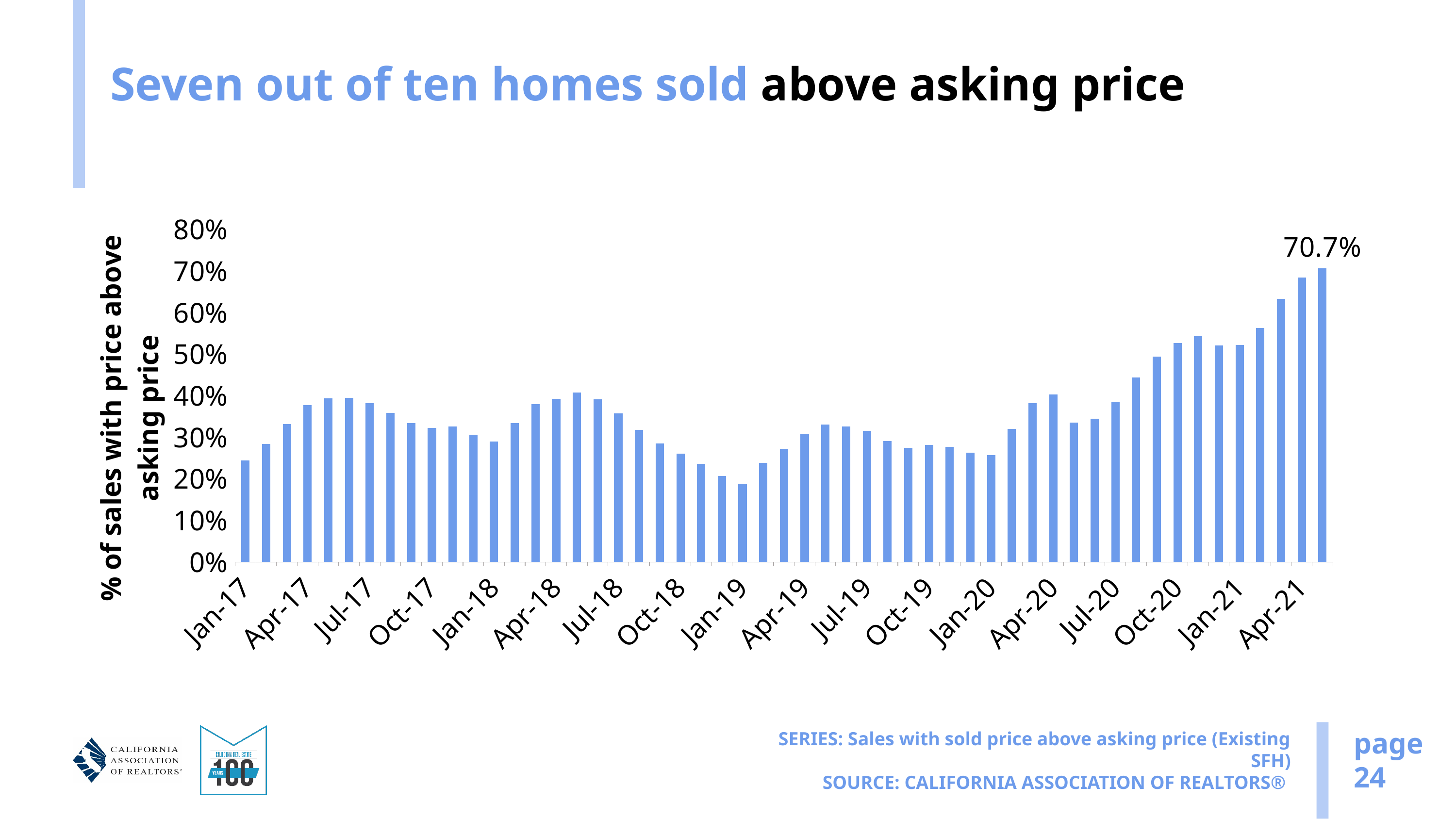
Which is larger, the value for Jan-17 or the value for Jan-21? Jan-21 Is the value for Oct-20 greater or less than 50%? greater Is the value for Jan-17 greater or less than 30%? less What is the title of the vertical axis? % of sales with price above asking price Do the values generally rise or fall from Jan-20 to the last bar? rise Is the value for Jan-17 greater or less than 20%? greater What kind of chart is shown on the slide? bar chart What value is printed on the rightmost (latest) bar of the chart? 70.7% Which is larger, the value for Jan-19 or the value for Jan-20? Jan-20 Which bar has the highest value in the chart? the rightmost (latest) bar, 70.7%